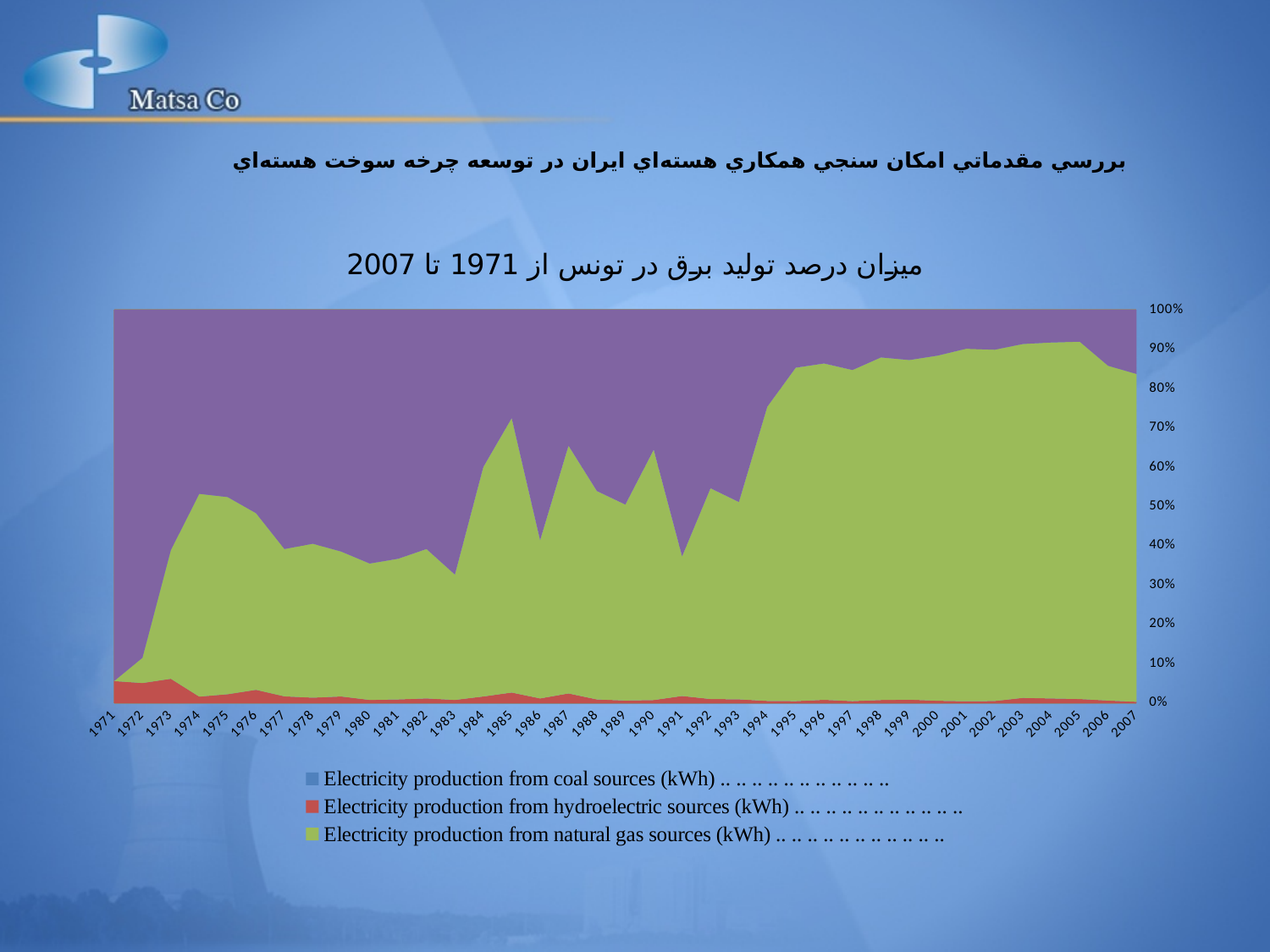
How many series does the legend list? 3 How many years are shown along the x axis? 37 What is the first year shown on the x axis? 1971 What is the last year shown on the x axis? 2007 Is the share of electricity production from natural gas sources in 1985 greater or less than 60%? greater Which year has the larger share of electricity production from natural gas sources, 1991 or 1995? 1995 Is the share of electricity production from natural gas sources in 1971 greater or less than 10%? less Is the share of electricity production from hydroelectric sources in 1973 greater or less than 10%? less What kind of chart is shown on the slide? Stacked area chart Overall, does the share of electricity production from natural gas sources rise or fall from 1971 to 2007? rise